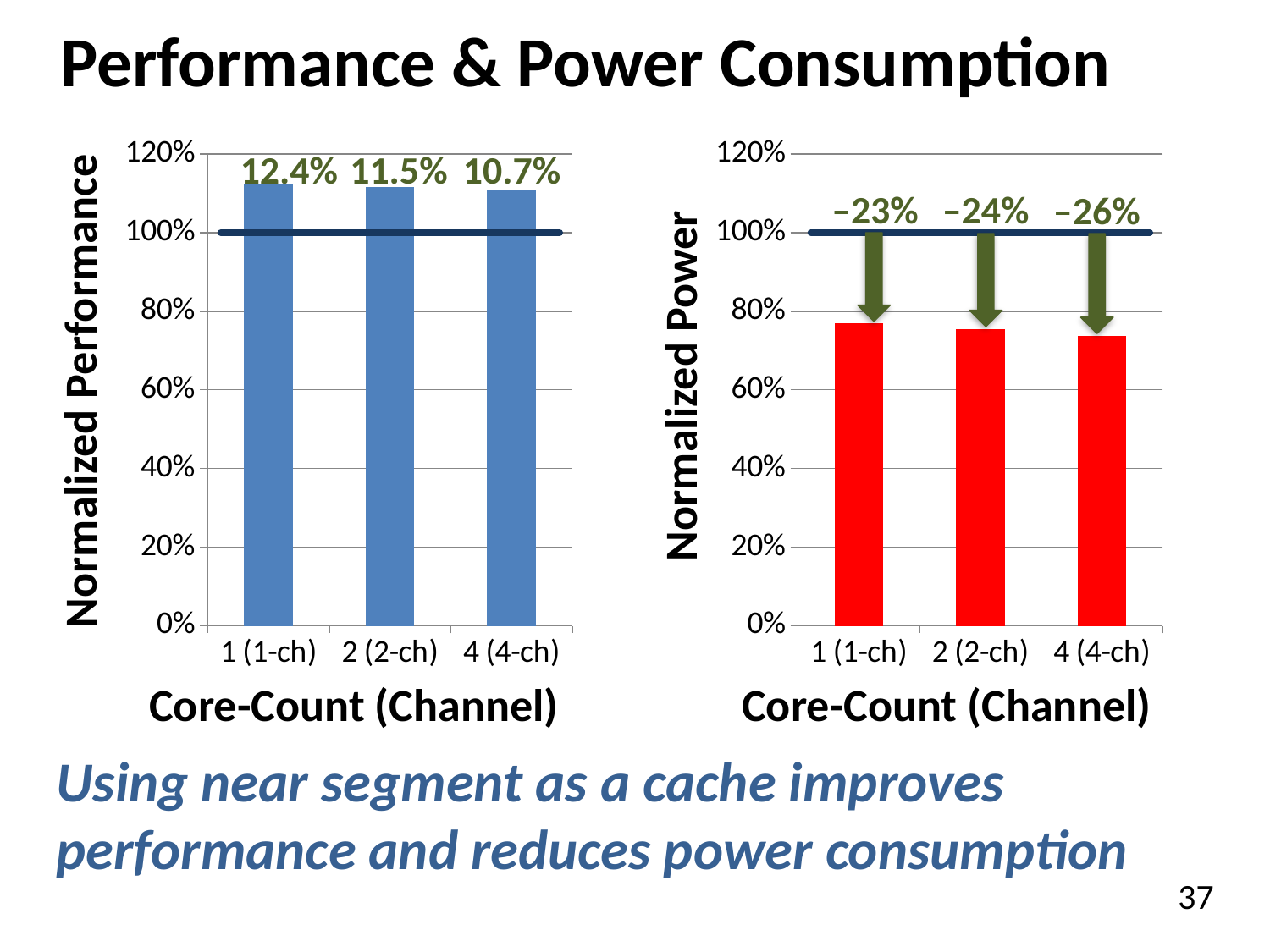
In the right chart (Normalized Power), which core-count configuration has the lowest bar? 4 (4-ch) In the left chart (Normalized Performance), what performance improvement is labeled above the bar for 4 (4-ch)? 10.7% In the right chart (Normalized Power), what power reduction is labeled for 2 (2-ch)? –24% In the right chart (Normalized Power), is the value for 1 (1-ch) greater or less than 80%? less How many core-count categories are shown in the right chart (Normalized Power)? 3 What is the x-axis title of the right chart (Normalized Power)? Core-Count (Channel) What kind of chart is the left chart (Normalized Performance)? bar chart In the left chart (Normalized Performance), is the value for 2 (2-ch) greater or less than 100%? greater In the left chart (Normalized Performance), what performance improvement is labeled above the bar for 1 (1-ch)? 12.4% In the left chart (Normalized Performance), which core-count configuration has the highest bar? 1 (1-ch) In the left chart (Normalized Performance), do the bar values rise or fall as core-count increases from 1 (1-ch) to 4 (4-ch)? fall In the right chart (Normalized Power), what power reduction is labeled for 4 (4-ch)? –26%